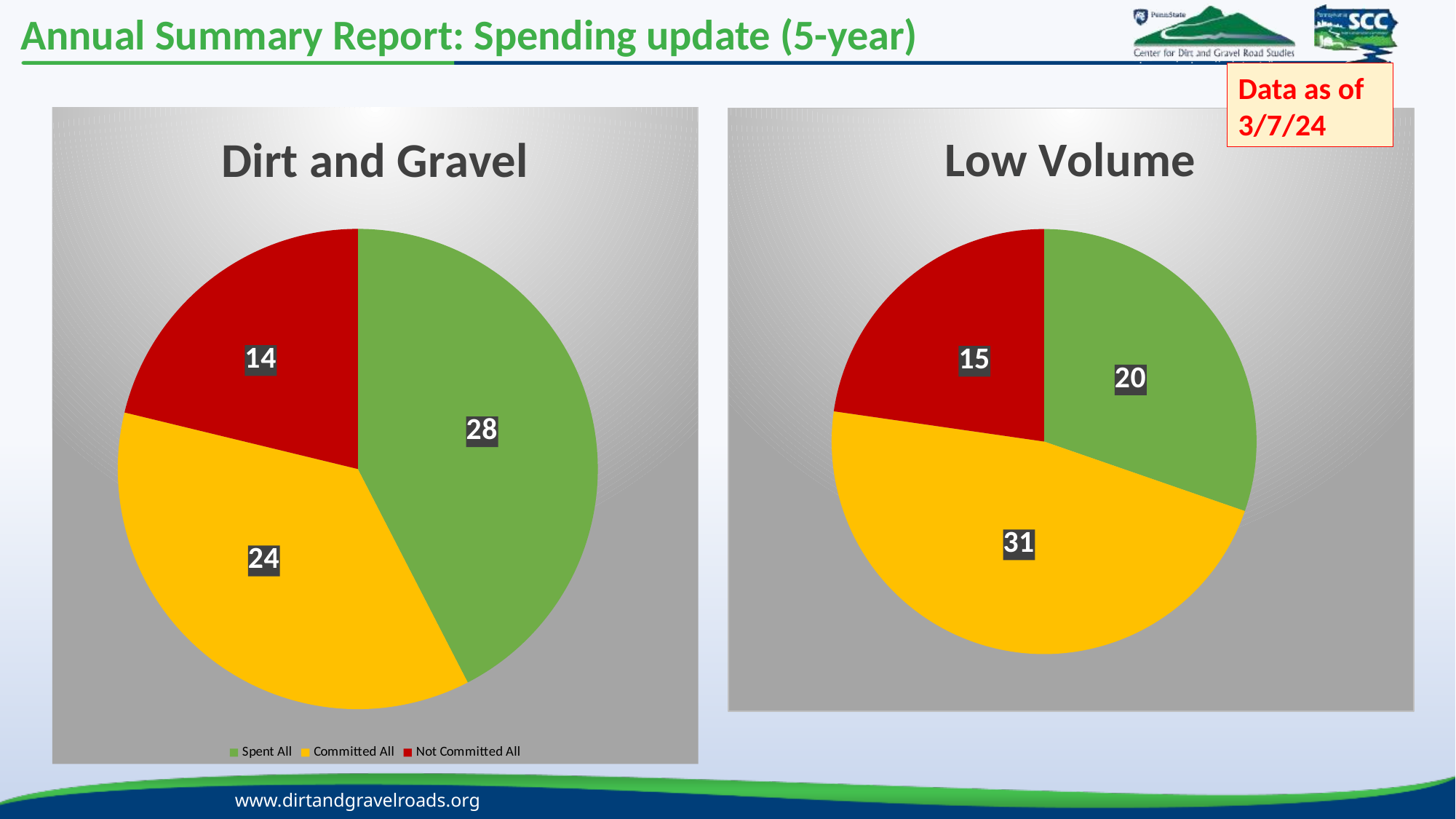
In the Low Volume chart, what is the value of the red (Not Committed All) slice? 15 In the Dirt and Gravel chart, what is the value for Not Committed All? 14 In the Dirt and Gravel chart, what is the difference between Spent All and Not Committed All? 14 In the Low Volume chart, what is the value of the yellow (Committed All) slice? 31 In the Dirt and Gravel chart, which category has the smallest slice? Not Committed All What type of chart is used for Low Volume? Pie chart In the Dirt and Gravel chart, what is the value for Spent All? 28 Which is larger: Spent All in the Dirt and Gravel chart or the green Spent All slice in the Low Volume chart? Dirt and Gravel How many slices does the Dirt and Gravel pie chart have? 3 In the Dirt and Gravel chart, which category has the largest slice? Spent All In the Low Volume chart, which slice is the largest? Committed All (yellow) In the Low Volume chart, what is the difference between the yellow slice (31) and the green slice (20)? 11